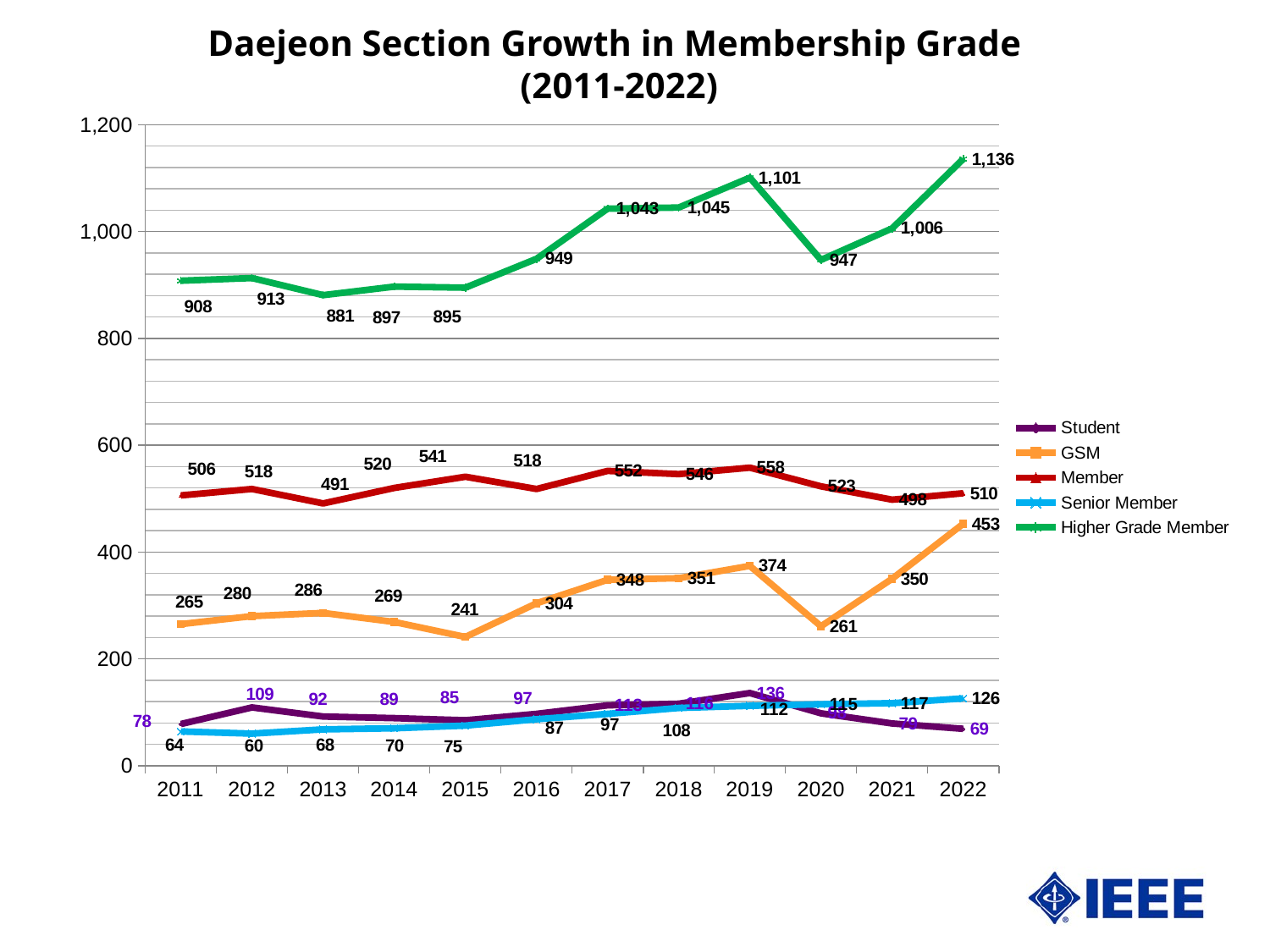
How many series does the legend list? 5 What kind of chart is shown on the slide? line chart What is the value for Member in 2019? 558 Is the Higher Grade Member value for 2020 greater or less than 1,000? less What is the value for Higher Grade Member in 2022? 1,136 How many years are shown on the x axis? 12 What is the value for GSM in 2015? 241 What is the difference between the Higher Grade Member values in 2022 and 2011? 228 Which is larger in 2022, the GSM value or the Member value? Member What is the value for Senior Member in 2011? 64 In which year is the GSM value lowest? 2015 In which year is the Higher Grade Member value highest? 2022